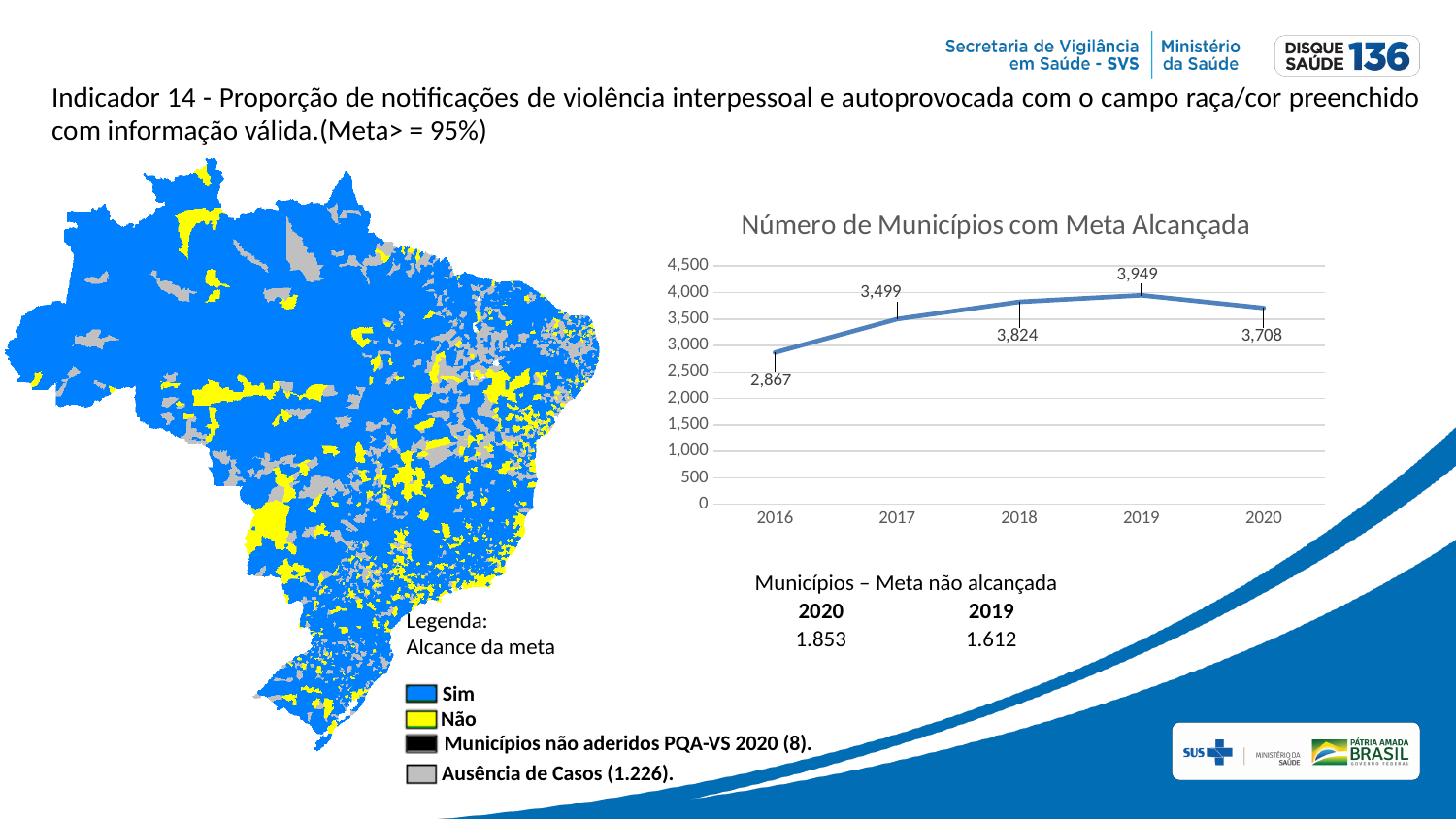
In the chart 'Número de Municípios com Meta Alcançada', which year has the lowest value? 2016 In the chart 'Número de Municípios com Meta Alcançada', what is the value for 2018? 3,824 In the chart 'Número de Municípios com Meta Alcançada', is the value for 2016 greater or less than 3,000? less In the chart 'Número de Municípios com Meta Alcançada', what is the difference between the values for 2017 and 2016? 632 How many years are plotted in the chart 'Número de Municípios com Meta Alcançada'? 5 What is the title of the line chart on the slide? Número de Municípios com Meta Alcançada In the chart 'Número de Municípios com Meta Alcançada', which is larger, the value for 2017 or the value for 2020? 2020 What type of chart is 'Número de Municípios com Meta Alcançada'? line chart In the chart 'Número de Municípios com Meta Alcançada', what is the difference between the values for 2019 and 2020? 241 In the chart 'Número de Municípios com Meta Alcançada', what is the value for 2016? 2,867 In the chart 'Número de Municípios com Meta Alcançada', what is the value for 2020? 3,708 In the chart 'Número de Municípios com Meta Alcançada', which year has the highest value? 2019